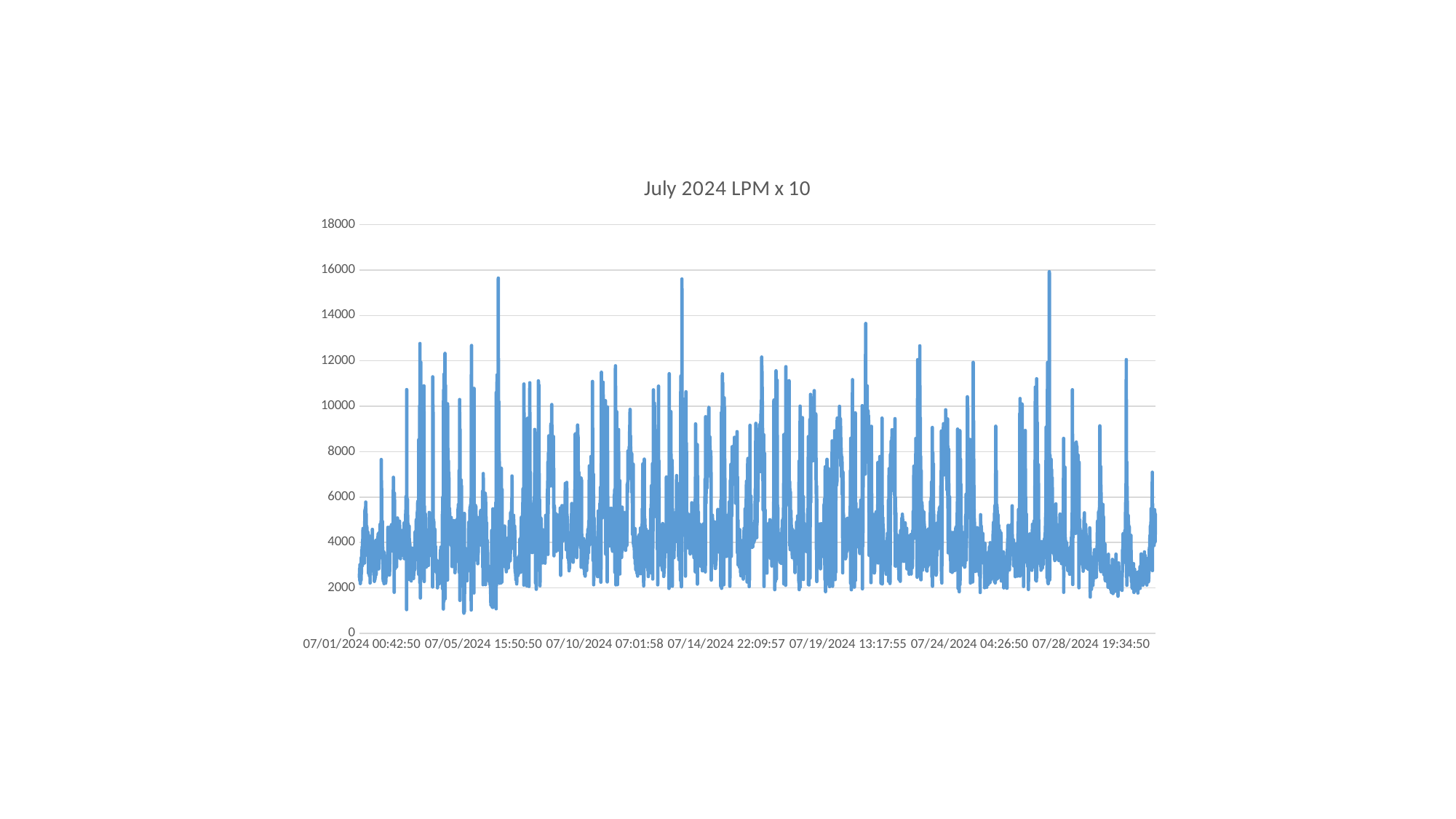
Is the highest peak in the chart greater or less than 14000? greater What kind of chart is shown on the slide? line chart What is the last date label on the horizontal axis? 07/28/2024 19:34:50 How many date labels are printed along the horizontal axis? 7 Is the highest peak in the chart greater or less than 18000? less What is the first date label on the horizontal axis? 07/01/2024 00:42:50 What is the highest value shown on the vertical axis? 18000 What is the title of the chart? July 2024 LPM x 10 Is the lowest value in the chart greater or less than 2000? less